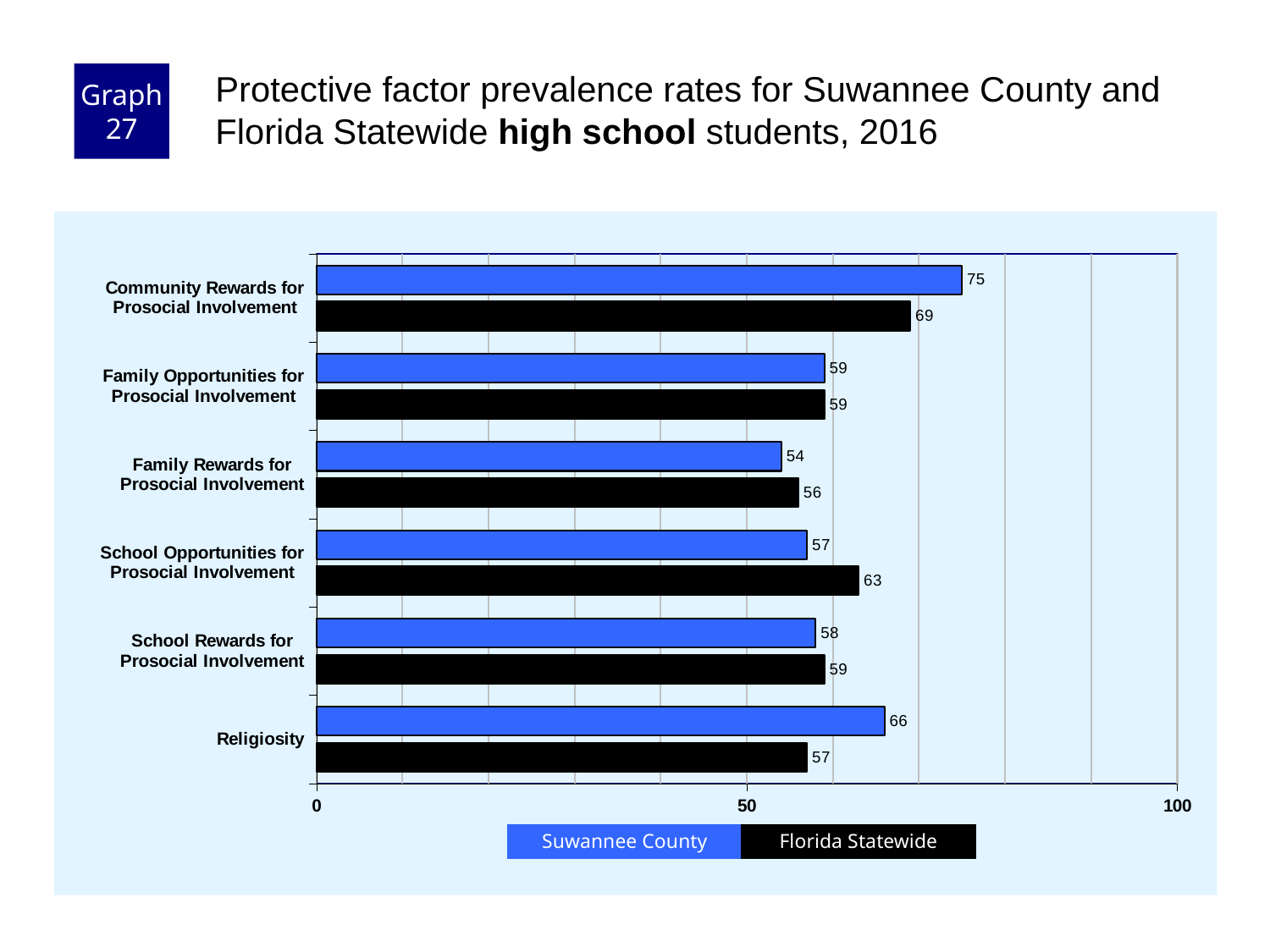
Which category has the highest Suwannee County value? Community Rewards for Prosocial Involvement Which category has the lowest Suwannee County value? Family Rewards for Prosocial Involvement What is the Florida Statewide value for Religiosity? 57 What is the difference between the Suwannee County and Florida Statewide values for Religiosity? 9 How many categories are shown on the chart? 6 What is the Florida Statewide value for School Opportunities for Prosocial Involvement? 63 What is the Suwannee County value for Community Rewards for Prosocial Involvement? 75 For Community Rewards for Prosocial Involvement, which is larger: Suwannee County or Florida Statewide? Suwannee County What kind of chart is shown on the slide? bar chart What is the difference between the Suwannee County and Florida Statewide values for School Opportunities for Prosocial Involvement? 6 How many series does the legend list? 2 Is the Suwannee County value for Religiosity greater or less than 50? greater